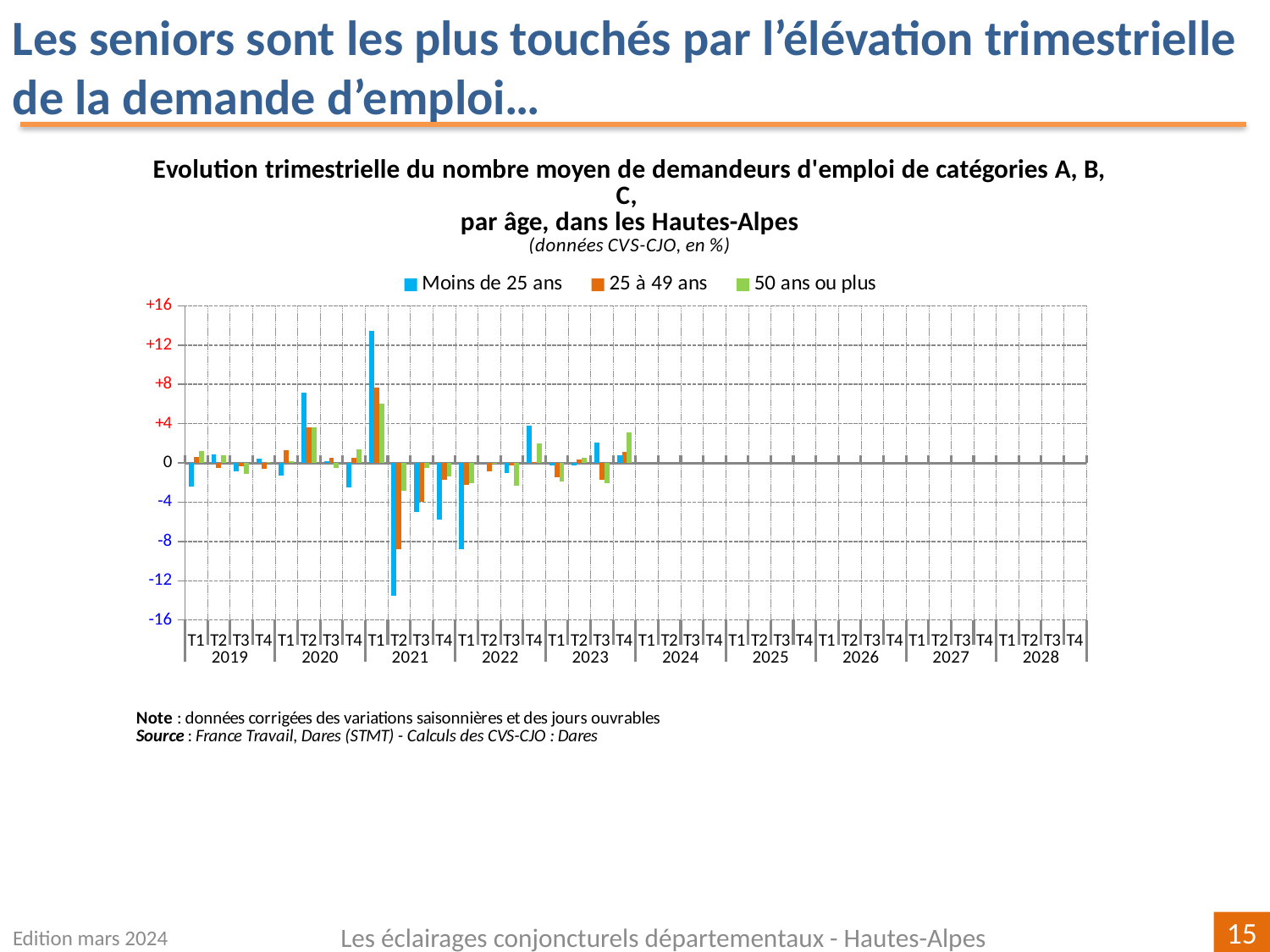
Is the value for 25 à 49 ans in T2 2021 greater or less than -8? less Is the value for Moins de 25 ans in T2 2021 greater or less than -12? less What kind of chart is shown on the slide? bar chart Which series has the highest value in T1 2021? Moins de 25 ans Which series has the lowest value in T2 2021? Moins de 25 ans How many series does the legend list? 3 How many years are labelled on the x axis? 10 Which series is shown in blue in the legend? Moins de 25 ans Is the value for 50 ans ou plus in T1 2021 greater or less than +4? greater In T1 2021, which is larger: the value for Moins de 25 ans or the value for 50 ans ou plus? Moins de 25 ans Which series is shown in green in the legend? 50 ans ou plus